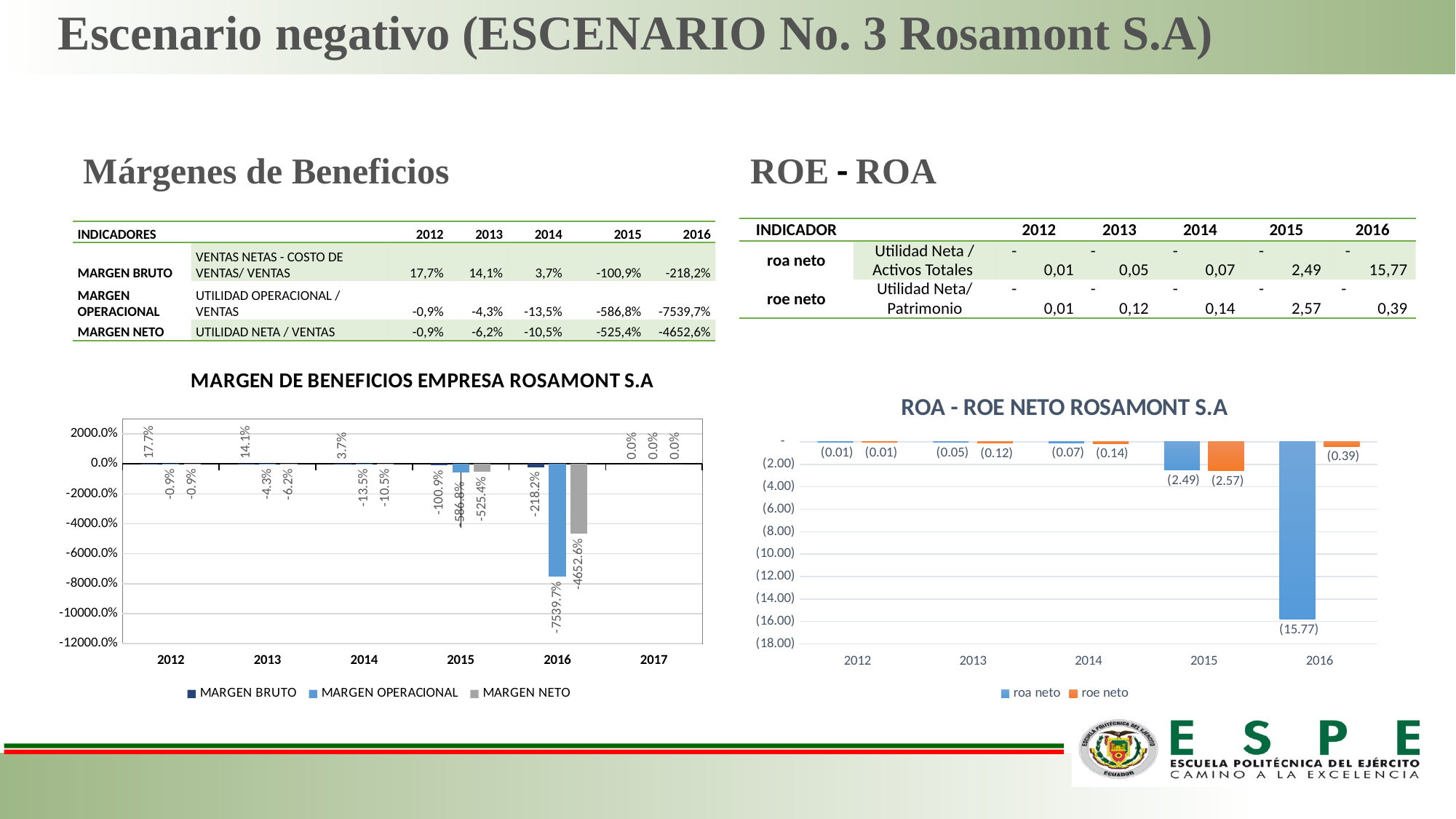
What kind of chart is the ROA - ROE NETO ROSAMONT S.A chart? Bar chart In the ROA - ROE NETO ROSAMONT S.A chart, how many series does the legend list? 2 In the MARGEN DE BENEFICIOS EMPRESA ROSAMONT S.A chart, what is the MARGEN BRUTO value for 2012? 17.7% In the ROA - ROE NETO ROSAMONT S.A chart, what is the roe neto value for 2015? (2.57) In the ROA - ROE NETO ROSAMONT S.A chart, what is the roa neto value for 2016? (15.77) In the MARGEN DE BENEFICIOS EMPRESA ROSAMONT S.A chart, how many series does the legend list? 3 In the MARGEN DE BENEFICIOS EMPRESA ROSAMONT S.A chart, which year has the lowest MARGEN NETO value? 2016 In the MARGEN DE BENEFICIOS EMPRESA ROSAMONT S.A chart, what is the MARGEN NETO value for 2015? -525.4% In the MARGEN DE BENEFICIOS EMPRESA ROSAMONT S.A chart, what is the MARGEN OPERACIONAL value for 2016? -7539.7% In the MARGEN DE BENEFICIOS EMPRESA ROSAMONT S.A chart, how many years are shown on the x axis? 6 In the MARGEN DE BENEFICIOS EMPRESA ROSAMONT S.A chart, what is the difference between the MARGEN BRUTO values for 2012 and 2013? 3.6% In the ROA - ROE NETO ROSAMONT S.A chart, which year has the lowest roa neto value? 2016